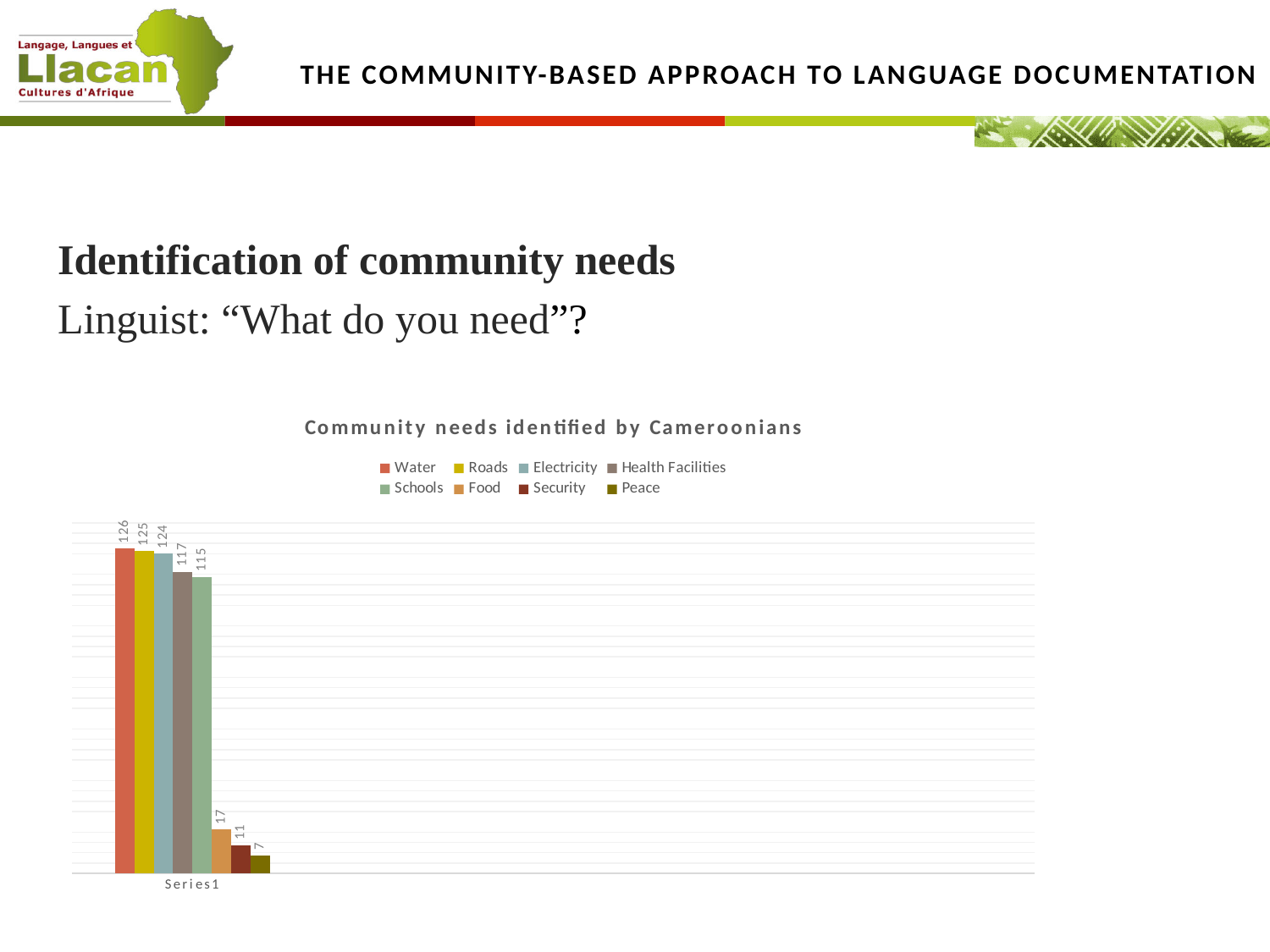
What is the value for Water? 126 What type of chart is shown on the slide? bar chart What is the value for Health Facilities? 117 Which need has the lowest value? Peace Which need has the highest value? Water Which is larger, the value for Security or the value for Food? Food What is the difference between the values for Roads and Electricity? 1 What is the value for Food? 17 What is the title of the chart? Community needs identified by Cameroonians What is the difference between the values for Water and Schools? 11 How many series does the chart legend list? 8 What is the value for Peace? 7